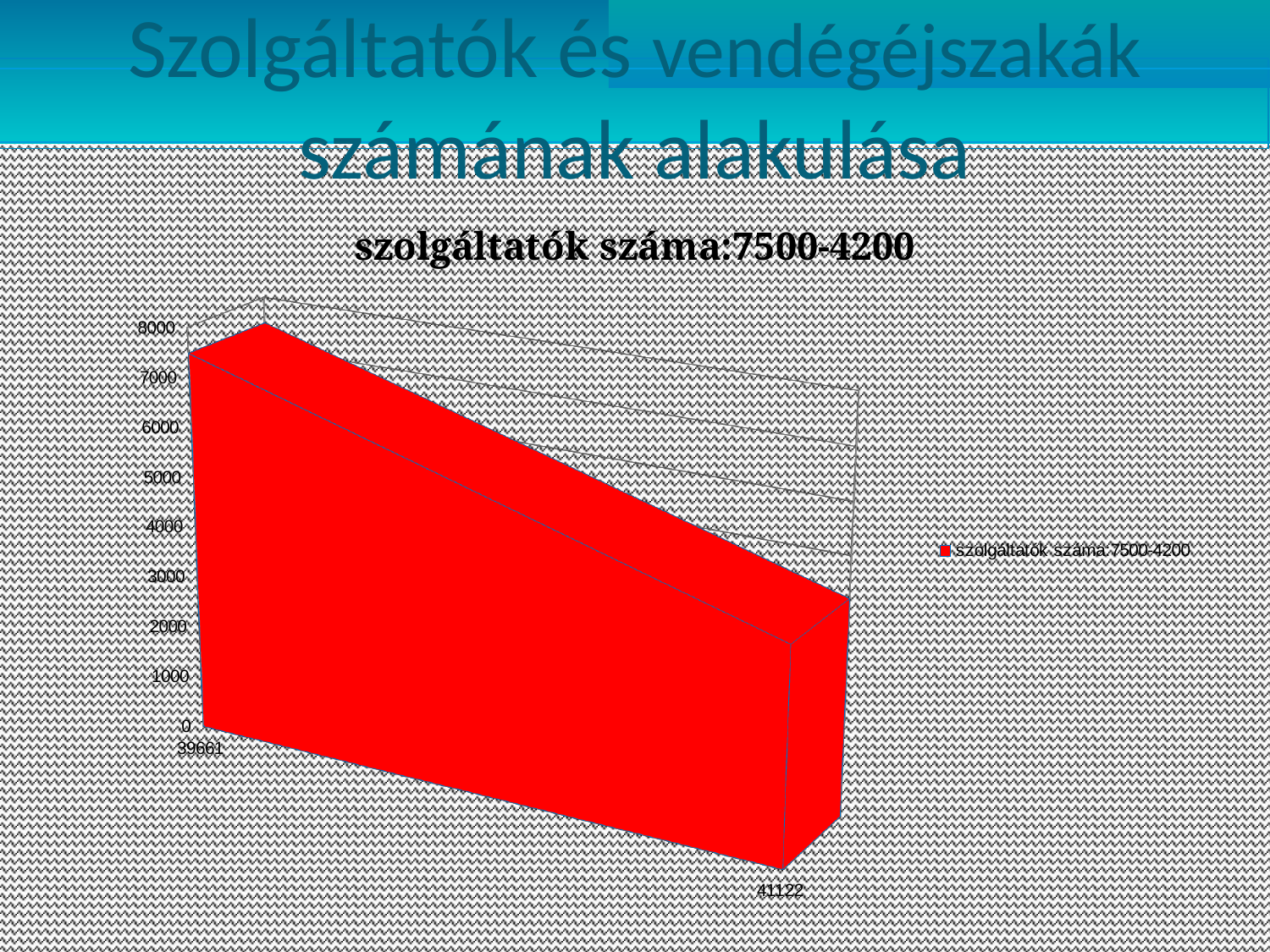
Is the value for 39661 greater or less than 7000? greater What kind of chart is shown on the slide? area chart Which category has the highest value in the chart? 39661 How many categories are shown on the x axis of the chart? 2 How many series does the legend list? 1 What is the title of the chart? szolgáltatók száma:7500-4200 What is the highest tick value shown on the vertical axis? 8000 Which category has the lowest value in the chart? 41122 Do the values rise or fall from 39661 to 41122? fall Which category has the larger value, 39661 or 41122? 39661 Is the value for 41122 greater or less than 5000? less